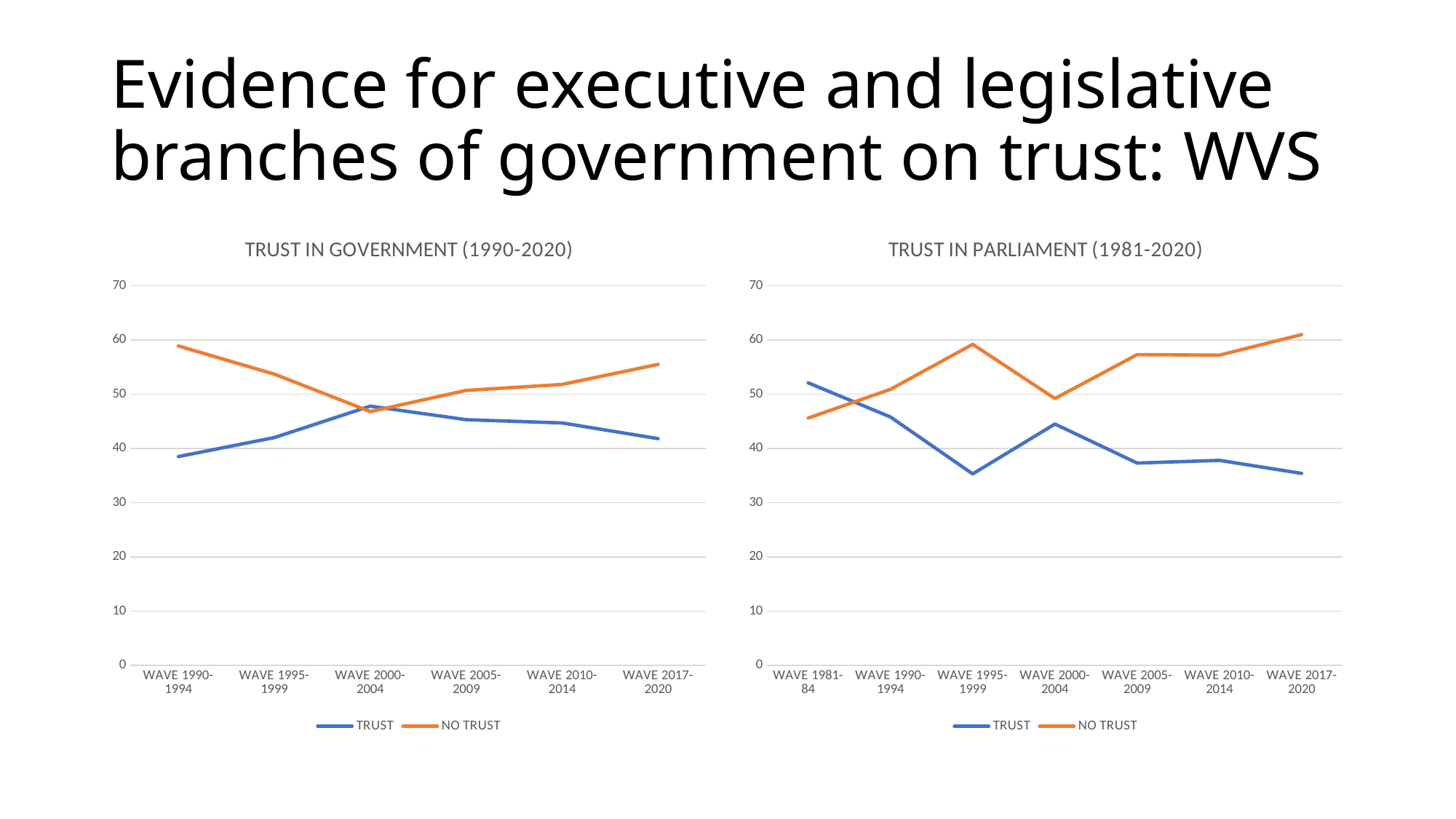
How many waves are plotted on the x axis of the TRUST IN PARLIAMENT (1981-2020) chart? 7 How many waves are plotted on the x axis of the TRUST IN GOVERNMENT (1990-2020) chart? 6 In the TRUST IN PARLIAMENT (1981-2020) chart, at which wave is the NO TRUST series highest? WAVE 2017-2020 What kind of chart is the TRUST IN GOVERNMENT (1990-2020) chart? Line chart How many series does the legend of the TRUST IN PARLIAMENT (1981-2020) chart list? 2 In the TRUST IN PARLIAMENT (1981-2020) chart, which series is larger at WAVE 1995-1999, TRUST or NO TRUST? NO TRUST In the TRUST IN GOVERNMENT (1990-2020) chart, does the NO TRUST series rise or fall from WAVE 2000-2004 to WAVE 2017-2020? Rise In the TRUST IN PARLIAMENT (1981-2020) chart, at which wave is the TRUST series highest? WAVE 1981-84 In the TRUST IN GOVERNMENT (1990-2020) chart, is the TRUST value for WAVE 1990-1994 greater or less than 40? less In the TRUST IN GOVERNMENT (1990-2020) chart, is the NO TRUST value for WAVE 1990-1994 greater or less than 50? greater What colour is the TRUST line in the TRUST IN GOVERNMENT (1990-2020) chart? Blue In the TRUST IN PARLIAMENT (1981-2020) chart, is the TRUST value for WAVE 1995-1999 greater or less than 40? less